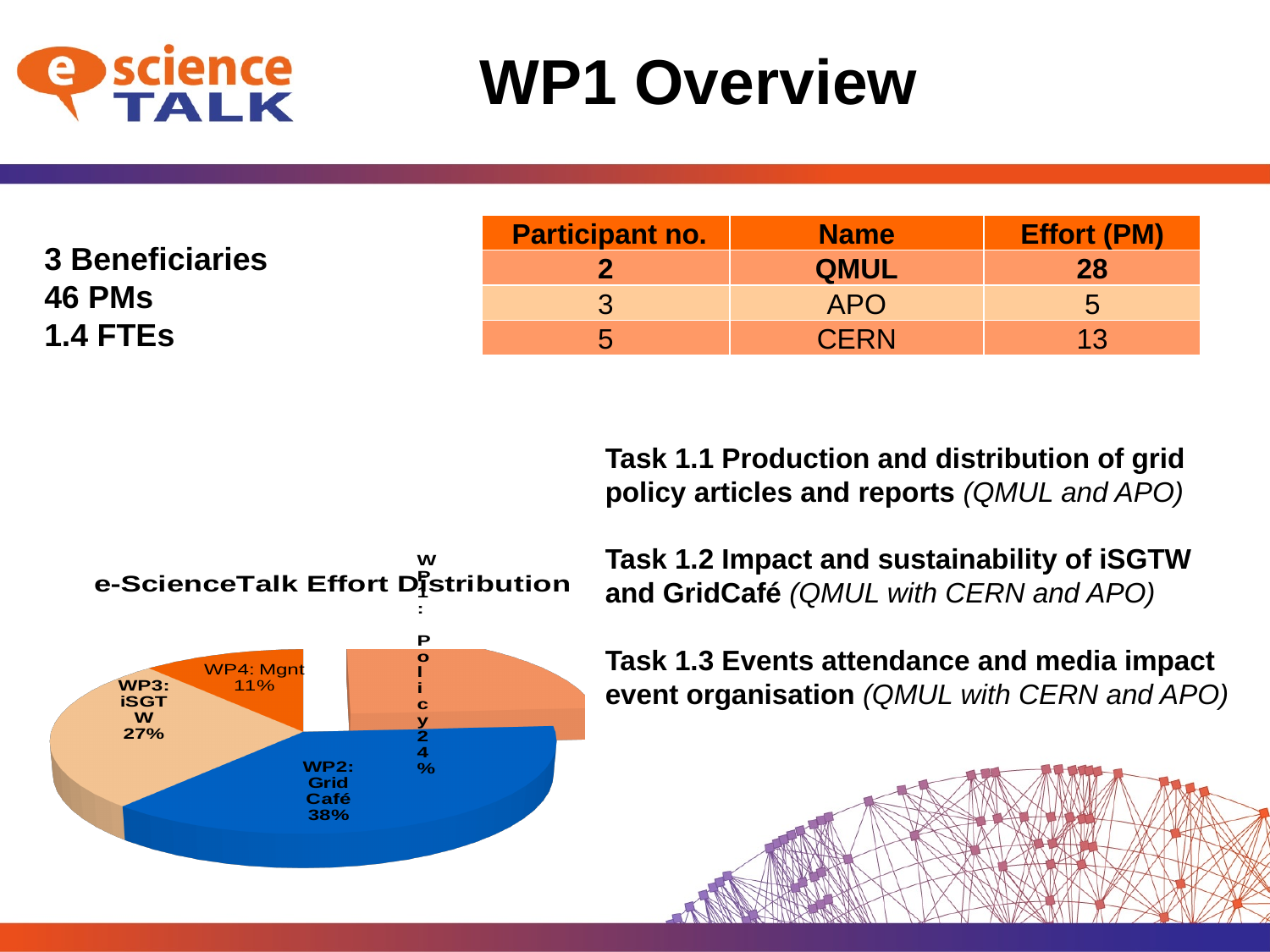
What share of the pie does WP2: Grid Café have? 38% What type of chart is shown on the slide? pie chart What share of the pie does WP3: iSGTW have? 27% What is the difference in percentage points between the WP2: Grid Café share and the WP4: Mgnt share? 27 Which slice of the pie chart is the smallest? WP4: Mgnt Which slice of the pie chart is coloured blue? WP2: Grid Café What share of the pie does WP1: Policy have? 24% What is the title of the chart? e-ScienceTalk Effort Distribution How many slices does the pie chart have? 4 Which slice of the pie chart is the largest? WP2: Grid Café Which is larger, the share for WP3: iSGTW or the share for WP1: Policy? WP3: iSGTW